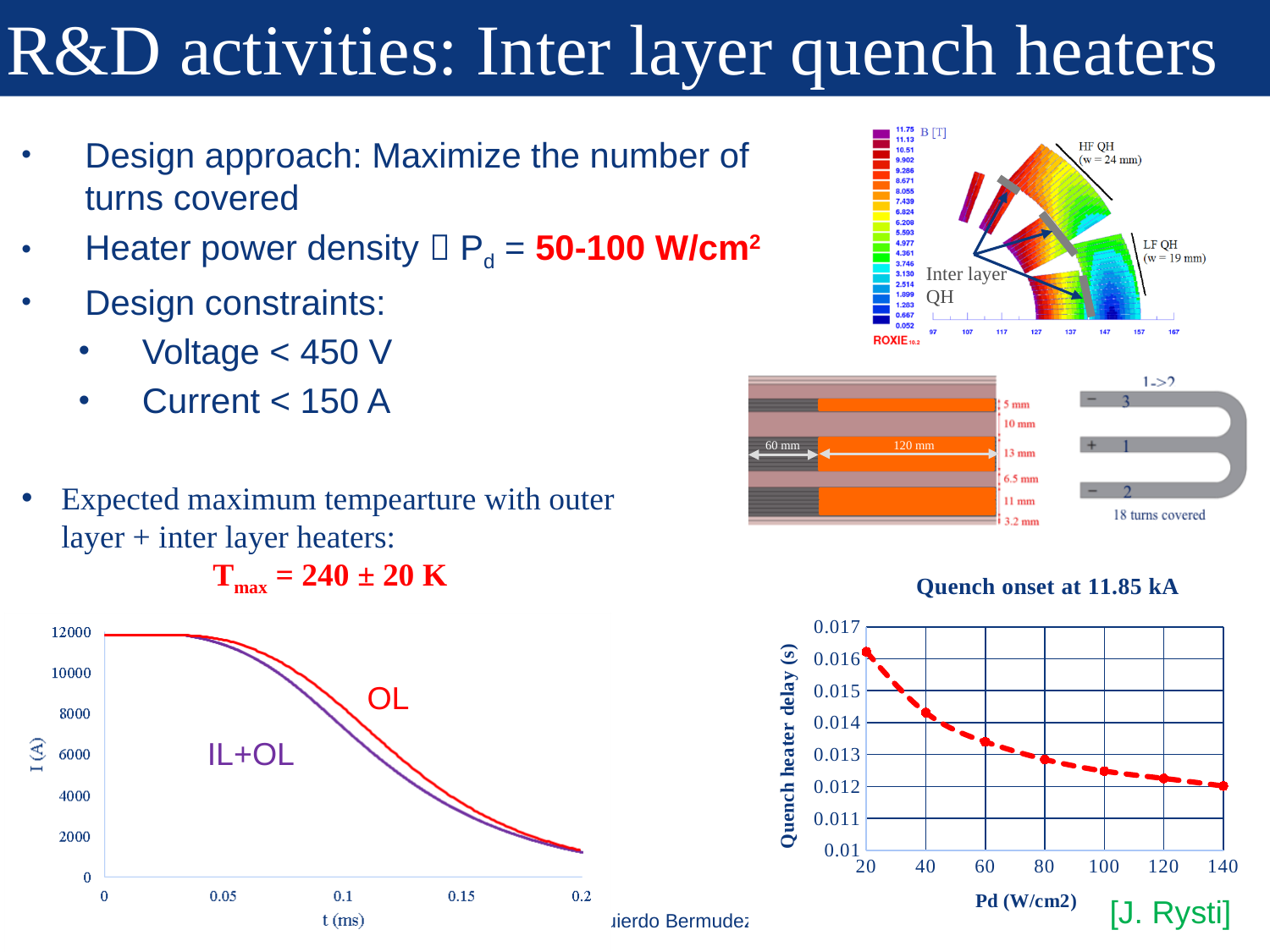
In the 'Quench onset at 11.85 kA' chart, how many data points are plotted? 7 In the 'Quench onset at 11.85 kA' chart, at which Pd value is the quench heater delay lowest? 140 In the bottom-left chart of I (A) against t (ms), is the IL+OL current at t = 0.2 greater or less than 2000? less In the 'Quench onset at 11.85 kA' chart, what is the label of the y axis? Quench heater delay (s) In the 'Quench onset at 11.85 kA' chart, at which Pd value is the quench heater delay highest? 20 What is the title of the chart on the bottom right of the slide? Quench onset at 11.85 kA In the 'Quench onset at 11.85 kA' chart, is the quench heater delay at Pd = 140 greater or less than 0.013? less In the 'Quench onset at 11.85 kA' chart, does the quench heater delay rise or fall as Pd increases? fall In the bottom-left chart of I (A) against t (ms), how many series are plotted? 2 In the 'Quench onset at 11.85 kA' chart, is the quench heater delay at Pd = 20 greater or less than 0.015? greater What kind of chart is the bottom-left chart showing I (A) against t (ms)? line chart In the bottom-left chart of I (A) against t (ms), at t = 0.1 which series has the larger current, OL or IL+OL? OL